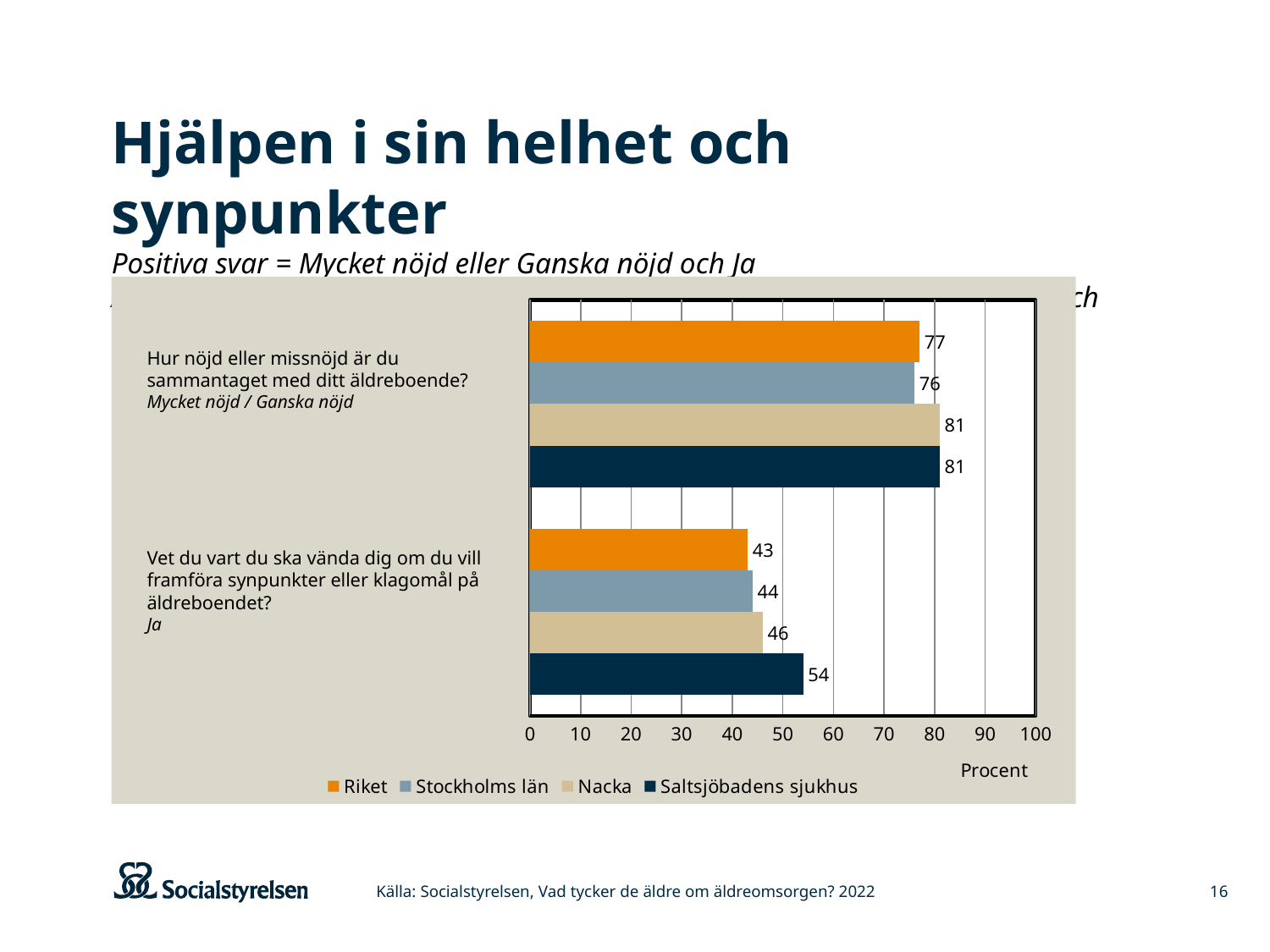
What is the value for Riket on the question "Hur nöjd eller missnöjd är du sammantaget med ditt äldreboende?"? 77 What is the difference between Saltsjöbadens sjukhus and Riket on the question "Vet du vart du ska vända dig om du vill framföra synpunkter eller klagomål på äldreboendet?"? 11 What is the label on the horizontal axis of the chart? Procent Which is larger on the question "Hur nöjd eller missnöjd är du sammantaget med ditt äldreboende?": Nacka or Stockholms län? Nacka Which series has the lowest value on the question "Vet du vart du ska vända dig om du vill framföra synpunkter eller klagomål på äldreboendet?"? Riket What is the value for Saltsjöbadens sjukhus on the question "Vet du vart du ska vända dig om du vill framföra synpunkter eller klagomål på äldreboendet?"? 54 What is the value for Nacka on the question "Vet du vart du ska vända dig om du vill framföra synpunkter eller klagomål på äldreboendet?"? 46 What kind of chart is shown on the slide? Bar chart How many series does the legend list? 4 What is the value for Stockholms län on the question "Hur nöjd eller missnöjd är du sammantaget med ditt äldreboende?"? 76 Is the value for Saltsjöbadens sjukhus on the question "Vet du vart du ska vända dig om du vill framföra synpunkter eller klagomål på äldreboendet?" greater or less than 50? greater Which series has the highest value on the question "Vet du vart du ska vända dig om du vill framföra synpunkter eller klagomål på äldreboendet?"? Saltsjöbadens sjukhus